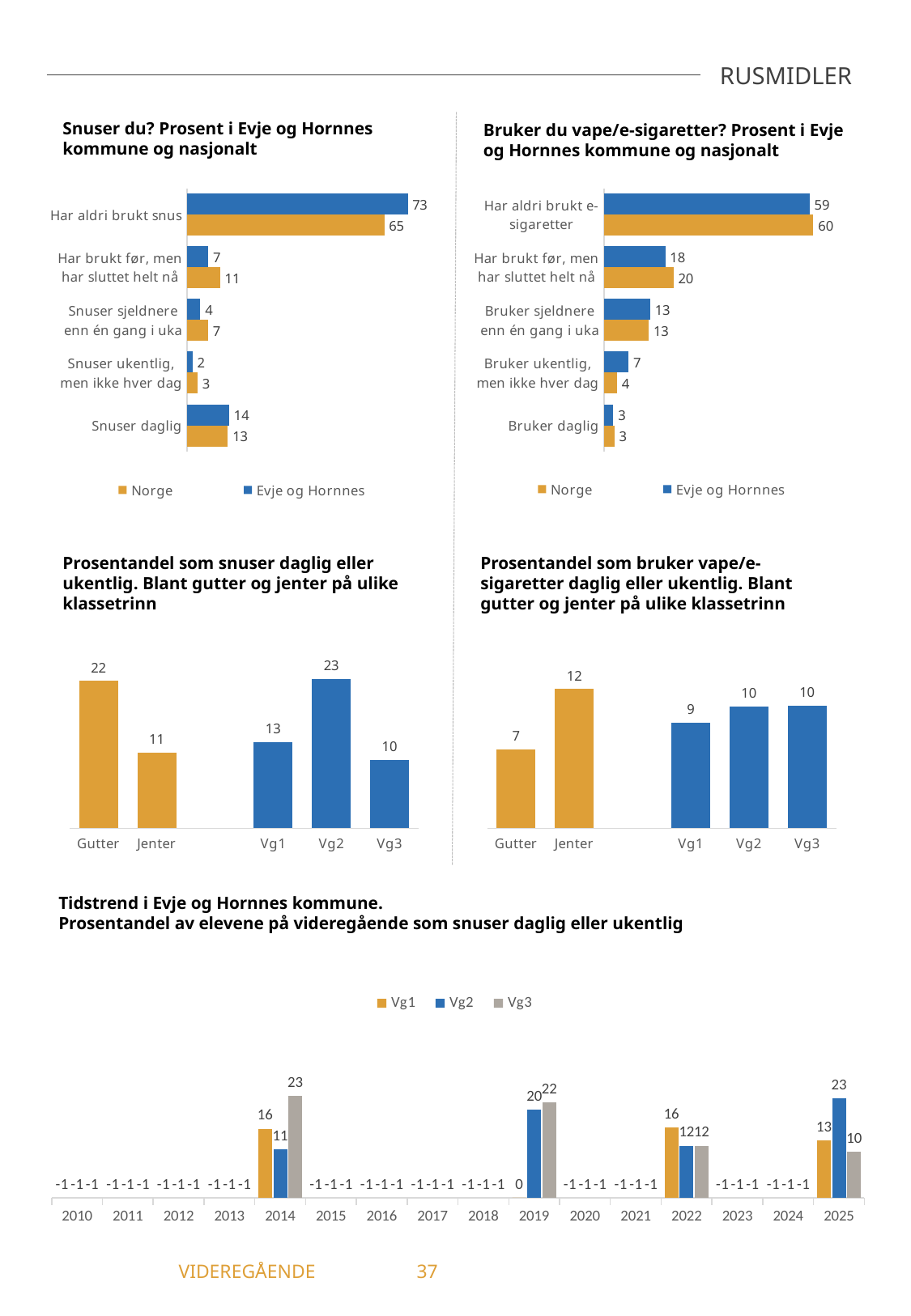
What kind of chart is 'Prosentandel som bruker vape/e-sigaretter daglig eller ukentlig. Blant gutter og jenter på ulike klassetrinn'? Bar chart In the chart 'Snuser du? Prosent i Evje og Hornnes kommune og nasjonalt', what is the value for Evje og Hornnes for 'Har aldri brukt snus'? 73 In the chart 'Prosentandel som snuser daglig eller ukentlig. Blant gutter og jenter på ulike klassetrinn', what is the difference between Gutter and Jenter? 11 In the chart 'Prosentandel som snuser daglig eller ukentlig. Blant gutter og jenter på ulike klassetrinn', which category has the highest value? Vg2 In the chart 'Tidstrend i Evje og Hornnes kommune', what is the Vg2 value for 2025? 23 In the chart 'Prosentandel som bruker vape/e-sigaretter daglig eller ukentlig. Blant gutter og jenter på ulike klassetrinn', which category has the lowest value? Gutter How many series does the legend list in the chart 'Bruker du vape/e-sigaretter? Prosent i Evje og Hornnes kommune og nasjonalt'? 2 In the chart 'Bruker du vape/e-sigaretter? Prosent i Evje og Hornnes kommune og nasjonalt', what is the Norge value for 'Har brukt før, men har sluttet helt nå'? 20 In the chart 'Snuser du? Prosent i Evje og Hornnes kommune og nasjonalt', what is the difference between the Norge and Evje og Hornnes values for 'Har brukt før, men har sluttet helt nå'? 4 In the chart 'Tidstrend i Evje og Hornnes kommune', what is the Vg3 value for 2014? 23 In the chart 'Bruker du vape/e-sigaretter? Prosent i Evje og Hornnes kommune og nasjonalt', what is the Evje og Hornnes value for 'Bruker ukentlig, men ikke hver dag'? 7 In the chart 'Snuser du? Prosent i Evje og Hornnes kommune og nasjonalt', which series has the larger value for 'Snuser daglig'? Evje og Hornnes